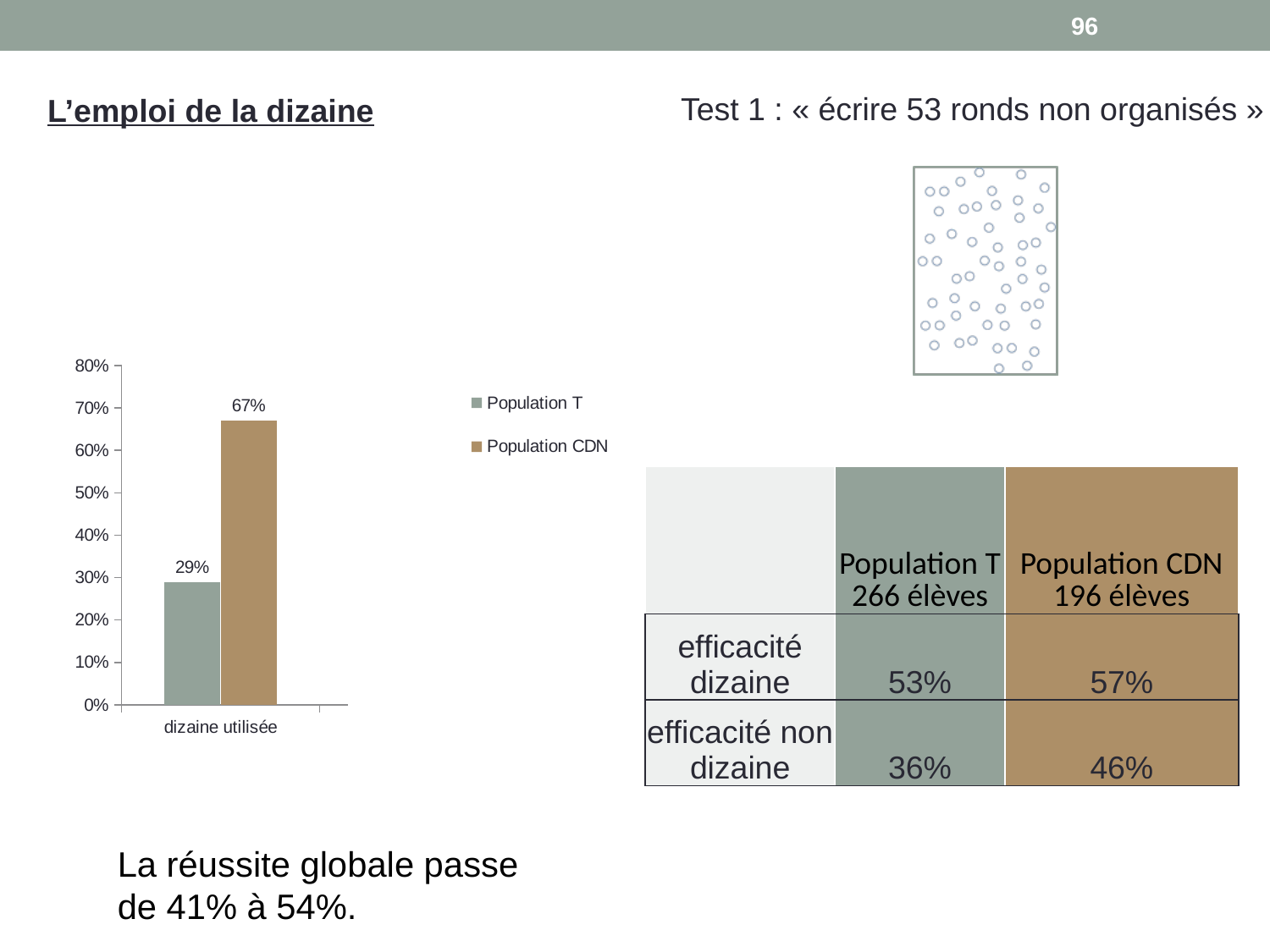
How many categories are shown on the x axis of the chart? 1 What is the difference between the Population CDN and Population T values for 'dizaine utilisée'? 38% Which series has the higher value for 'dizaine utilisée'? Population CDN Is the value for Population CDN greater or less than 60%? greater What is the value for Population CDN in the 'dizaine utilisée' category? 67% What is the maximum value shown on the y axis of the chart? 80% What kind of chart is shown on the slide? bar chart Which series has the lower value for 'dizaine utilisée'? Population T What is the category label on the x axis of the chart? dizaine utilisée How many series does the legend list? 2 What is the value for Population T in the 'dizaine utilisée' category? 29% Is the value for Population T greater or less than 40%? less